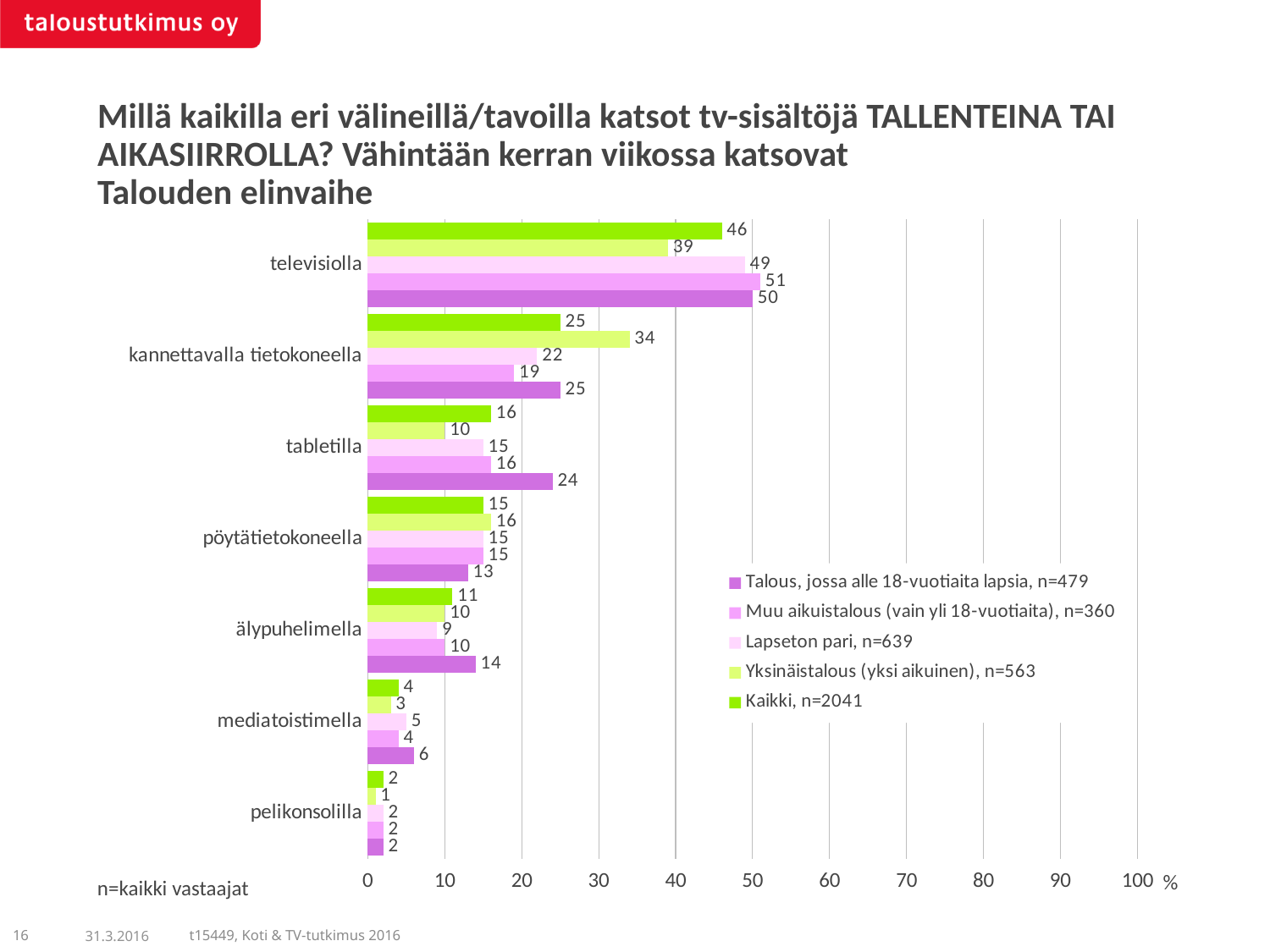
What is the difference between the 'Muu aikuistalous (vain yli 18-vuotiaita), n=360' and 'Yksinäistalous (yksi aikuinen), n=563' values in the 'televisiolla' category? 12 What is the value for 'Kaikki, n=2041' in the 'televisiolla' category? 46 What is the value for 'Talous, jossa alle 18-vuotiaita lapsia, n=479' in the 'tabletilla' category? 24 How many series does the legend list? 5 What is the value for 'Yksinäistalous (yksi aikuinen), n=563' in the 'kannettavalla tietokoneella' category? 34 What kind of chart is shown on the slide? bar chart Is the value for 'Lapseton pari, n=639' in the 'televisiolla' category greater or less than 40? greater In the 'älypuhelimella' category, which is larger: the value for 'Talous, jossa alle 18-vuotiaita lapsia, n=479' or for 'Lapseton pari, n=639'? Talous, jossa alle 18-vuotiaita lapsia, n=479 Which category has the lowest value for the 'Kaikki, n=2041' series? pelikonsolilla Which category has the highest value for the 'Kaikki, n=2041' series? televisiolla What is the sample size (n) given in the legend for 'Kaikki'? 2041 How many categories are shown on the chart? 7